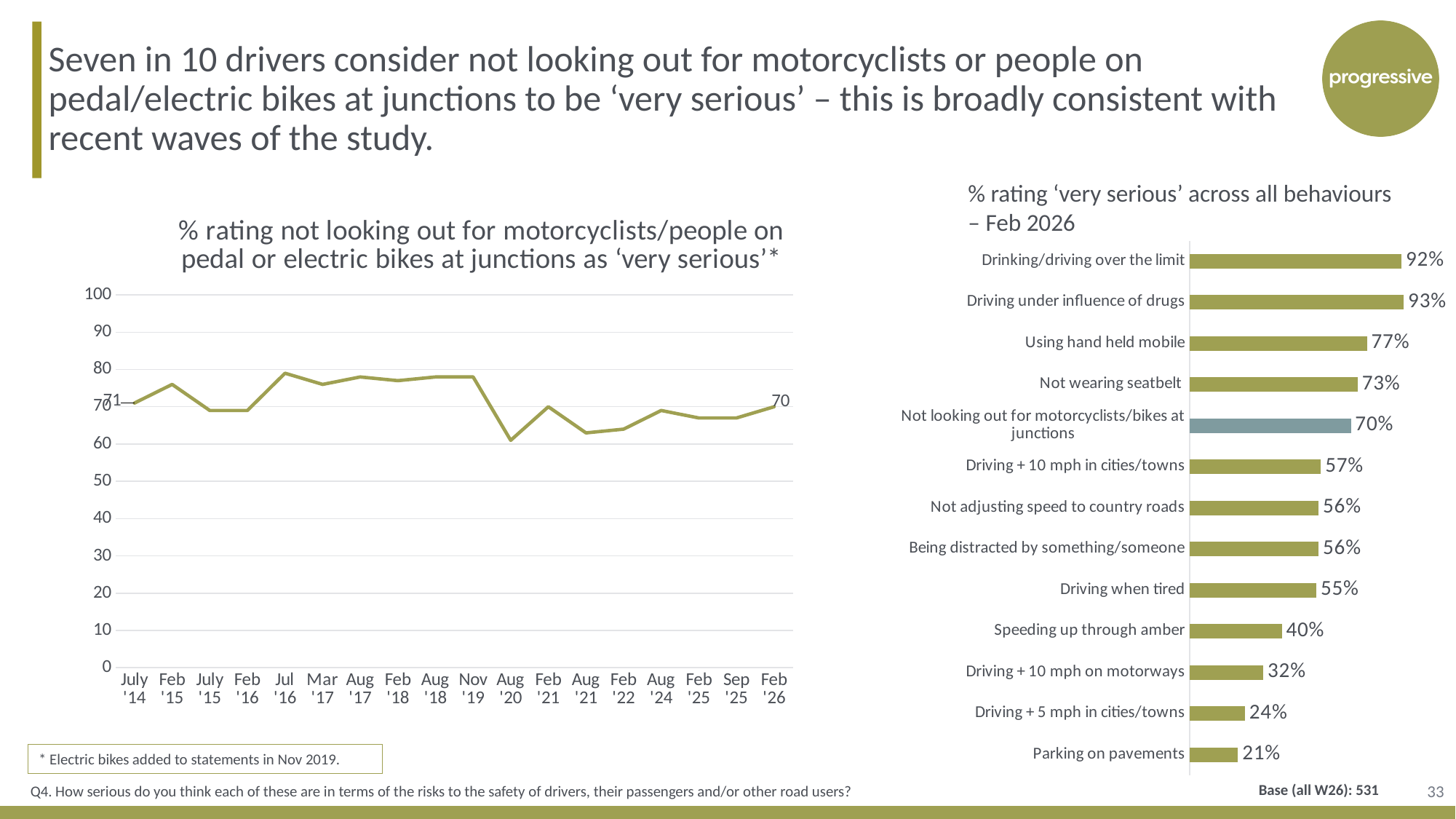
In the chart titled '% rating ‘very serious’ across all behaviours – Feb 2026', what is the difference between Drinking/driving over the limit and Not wearing seatbelt? 19% In the chart titled '% rating ‘very serious’ across all behaviours – Feb 2026', what is the value for Using hand held mobile? 77% What kind of chart is the one titled '% rating ‘very serious’ across all behaviours – Feb 2026'? Bar chart In the line chart on the left, what is the value for Feb '26? 70 In the line chart on the left, is the value for Aug '20 greater or less than 70? less In the chart titled '% rating ‘very serious’ across all behaviours – Feb 2026', which bar is shown in a different colour from the others? Not looking out for motorcyclists/bikes at junctions In the chart titled '% rating ‘very serious’ across all behaviours – Feb 2026', which is larger: Speeding up through amber or Driving + 10 mph on motorways? Speeding up through amber In the chart titled '% rating ‘very serious’ across all behaviours – Feb 2026', how many behaviours are listed? 13 In the chart titled '% rating ‘very serious’ across all behaviours – Feb 2026', which behaviour has the lowest value? Parking on pavements In the chart titled '% rating ‘very serious’ across all behaviours – Feb 2026', what is the value for Parking on pavements? 21% In the line chart on the left, what is the value for July '14? 71 In the chart titled '% rating ‘very serious’ across all behaviours – Feb 2026', which behaviour has the highest value? Driving under influence of drugs